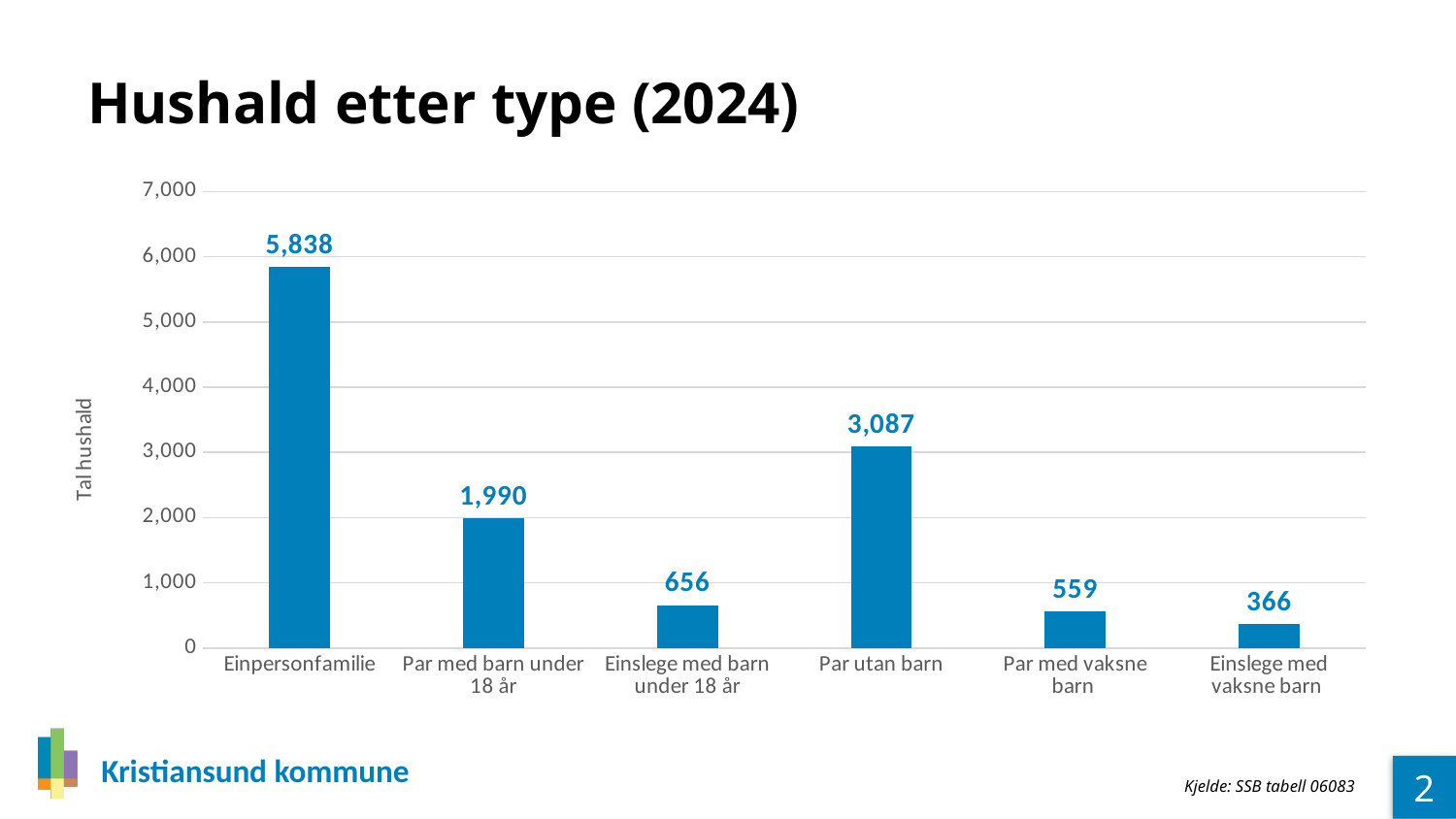
What is the value for Par utan barn? 3,087 What is the value for Einpersonfamilie? 5,838 What is the value for Einslege med vaksne barn? 366 Which category has the lowest value? Einslege med vaksne barn What is the difference between Einpersonfamilie and Par utan barn? 2,751 What is the label on the y axis? Tal hushald What is the difference between Einslege med barn under 18 år and Par med vaksne barn? 97 How many categories are shown on the x axis? 6 Which is larger, Par med barn under 18 år or Einslege med barn under 18 år? Par med barn under 18 år What kind of chart is this? bar chart Which category has the highest value? Einpersonfamilie Is the value for Par utan barn greater or less than 3,000? greater